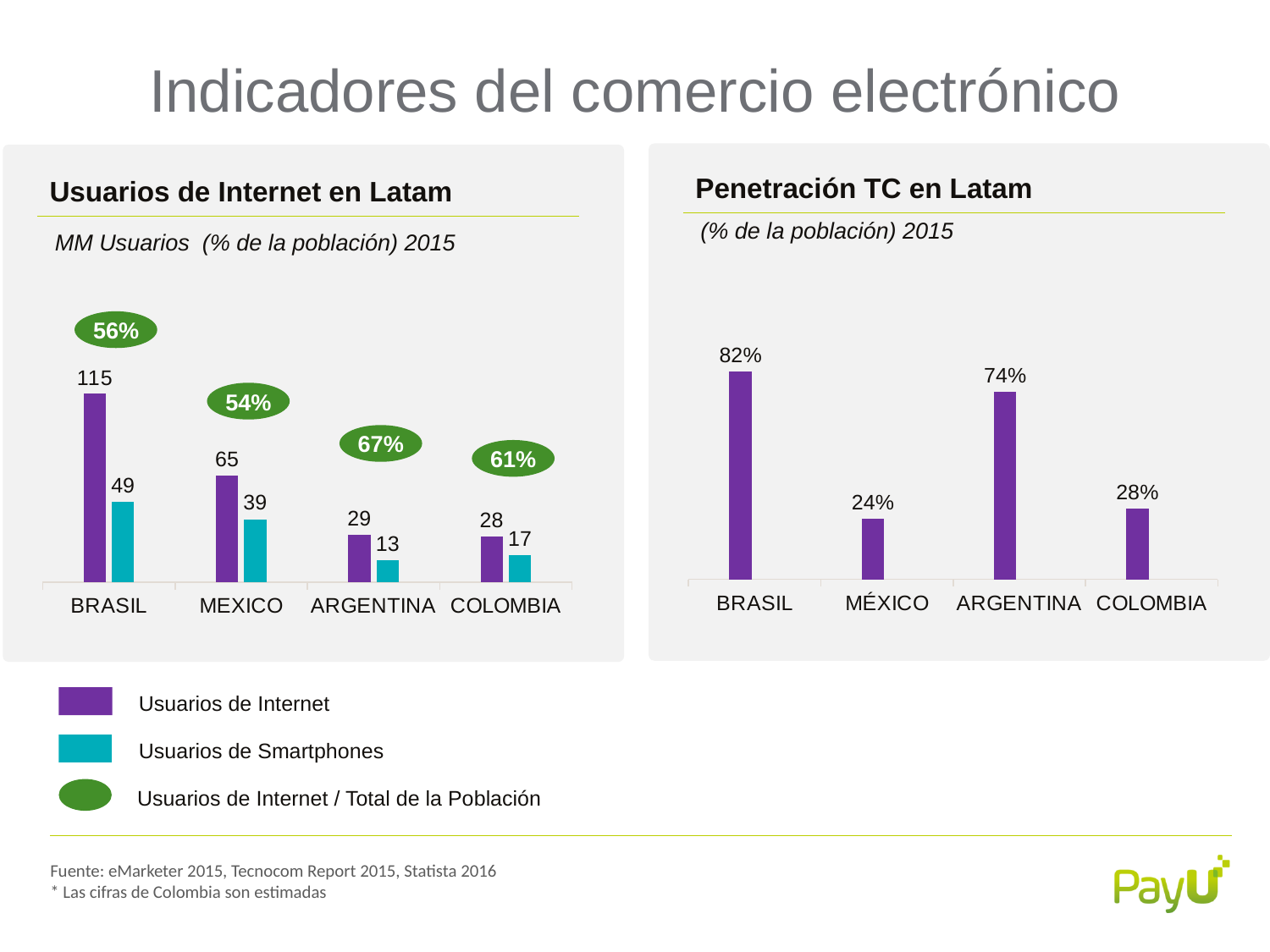
In the 'Usuarios de Internet en Latam' chart, what is the value of Usuarios de Smartphones for MEXICO? 39 In the 'Usuarios de Internet en Latam' chart, what is the value of Usuarios de Internet for BRASIL? 115 In the 'Penetración TC en Latam' chart, which country has the highest value? BRASIL In the 'Penetración TC en Latam' chart, which is larger, the value for MÉXICO or the value for COLOMBIA? COLOMBIA In the 'Usuarios de Internet en Latam' chart, what percentage is shown in the green oval for ARGENTINA? 67% In the 'Penetración TC en Latam' chart, what is the difference between the values for BRASIL and COLOMBIA? 54% In the 'Usuarios de Internet en Latam' chart, what is the difference between Usuarios de Internet and Usuarios de Smartphones for BRASIL? 66 In the 'Penetración TC en Latam' chart, which country has the lowest value? MÉXICO In the 'Usuarios de Internet en Latam' chart, which country has the lowest value for Usuarios de Smartphones? ARGENTINA In the 'Usuarios de Internet en Latam' chart, how many countries are shown on the x axis? 4 In the 'Penetración TC en Latam' chart, what is the value for ARGENTINA? 74% What kind of chart is the 'Penetración TC en Latam' chart? Bar chart